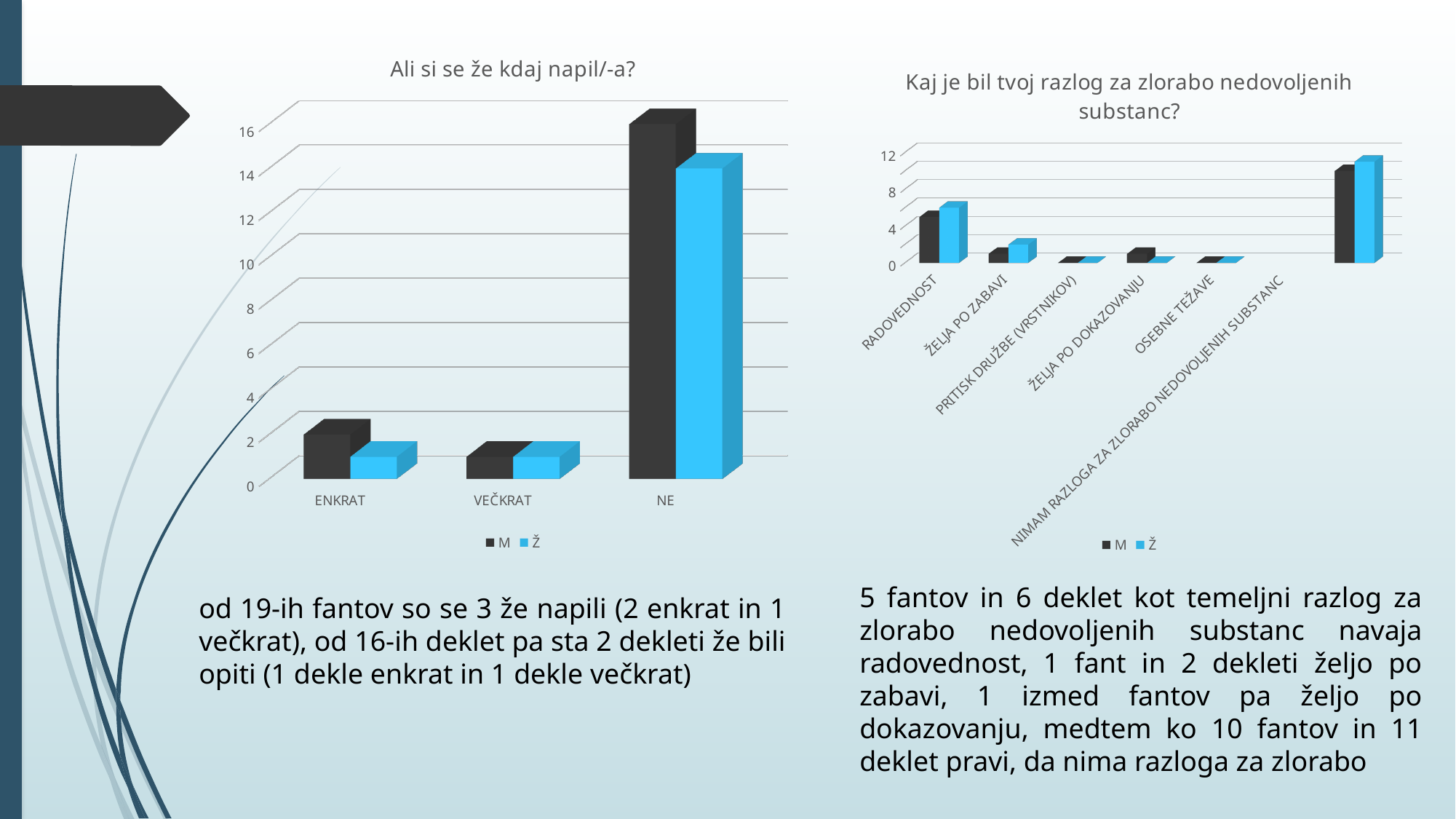
In the left chart "Ali si se že kdaj napil/-a?", for ENKRAT, which series has the larger value, M or Ž? M In the left chart "Ali si se že kdaj napil/-a?", how many series does the legend list? 2 In the left chart "Ali si se že kdaj napil/-a?", how many categories are shown on the x axis? 3 What kind of chart is the left chart titled "Ali si se že kdaj napil/-a?"? bar chart In the left chart "Ali si se že kdaj napil/-a?", what is the difference between the M and Ž values for NE? 2 In the right chart "Kaj je bil tvoj razlog za zlorabo nedovoljenih substanc?", is the M value for RADOVEDNOST greater or less than 8? less In the left chart "Ali si se že kdaj napil/-a?", what is the value of the Ž series for NE? 14 In the right chart "Kaj je bil tvoj razlog za zlorabo nedovoljenih substanc?", which category has the highest value for the Ž series? NIMAM RAZLOGA ZA ZLORABO NEDOVOLJENIH SUBSTANC In the left chart "Ali si se že kdaj napil/-a?", what is the value of the M series for NE? 16 In the left chart "Ali si se že kdaj napil/-a?", which category has the highest value for the M series? NE In the right chart "Kaj je bil tvoj razlog za zlorabo nedovoljenih substanc?", how many categories are shown on the x axis? 6 In the right chart "Kaj je bil tvoj razlog za zlorabo nedovoljenih substanc?", what are the two legend entries? M and Ž